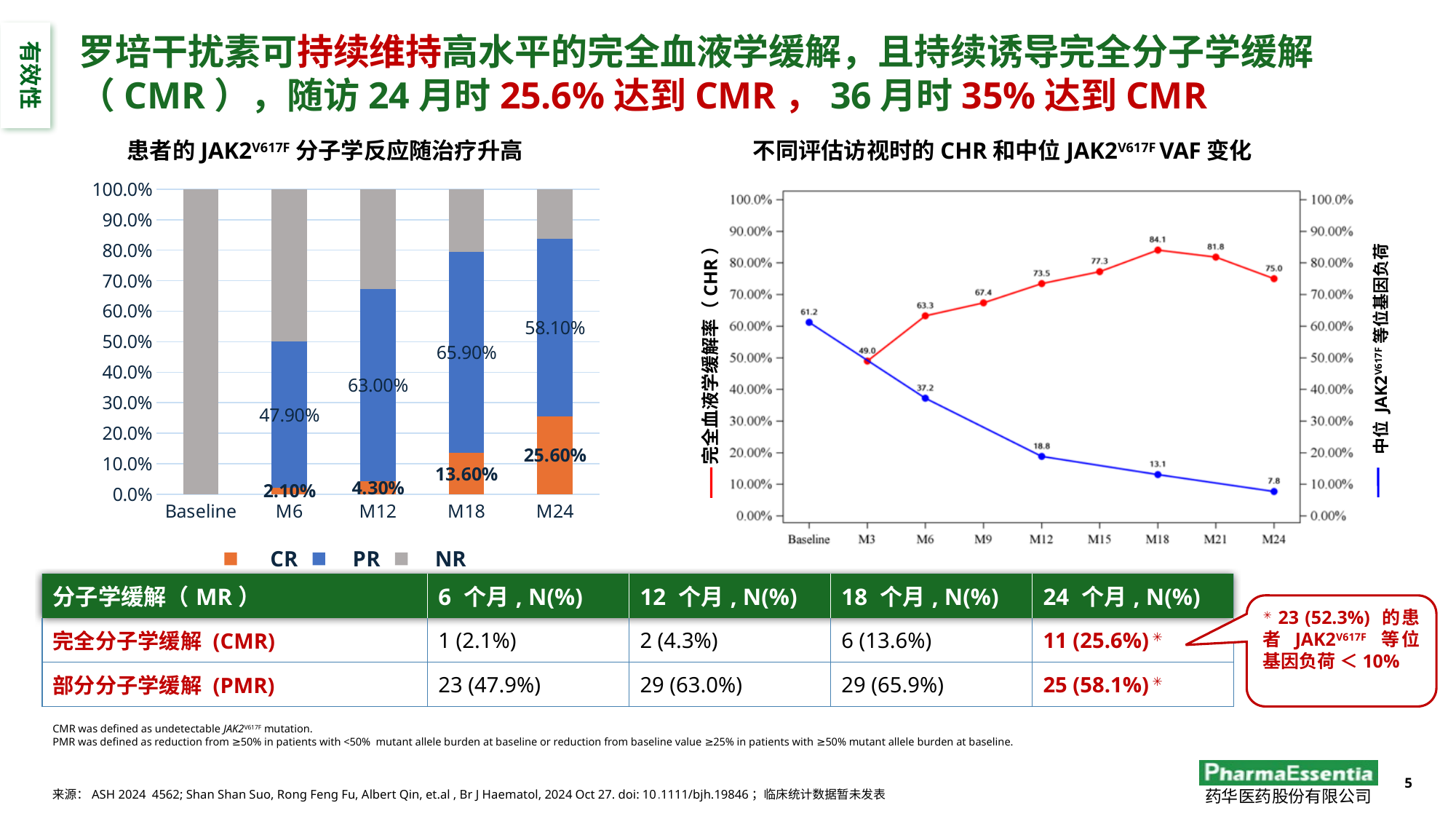
In the left chart, how many series does the legend list? 3 In the right chart (不同评估访视时的 CHR 和中位 JAK2V617F VAF 变化), what is the CHR value at M18? 84.1 In the right chart, does the blue median JAK2V617F VAF line rise or fall from Baseline to M24? Fall In the right chart, how many visit time points are shown on the x axis? 9 In the right chart, what is the median JAK2V617F VAF value at M24? 7.8 In the left chart, what is the PR value at M12? 63.00% In the left chart (患者的 JAK2V617F 分子学反应随治疗升高), what is the CR value at M24? 25.60% What type of chart is the left chart? Stacked bar chart In the left chart, at which time point is the CR value highest? M24 In the left chart, what is the difference between the PR values at M18 and M6? 18.00% In the right chart, which is larger: the CHR value at M12 or the CHR value at M6? M12 In the right chart, at which visit is the CHR value highest? M18